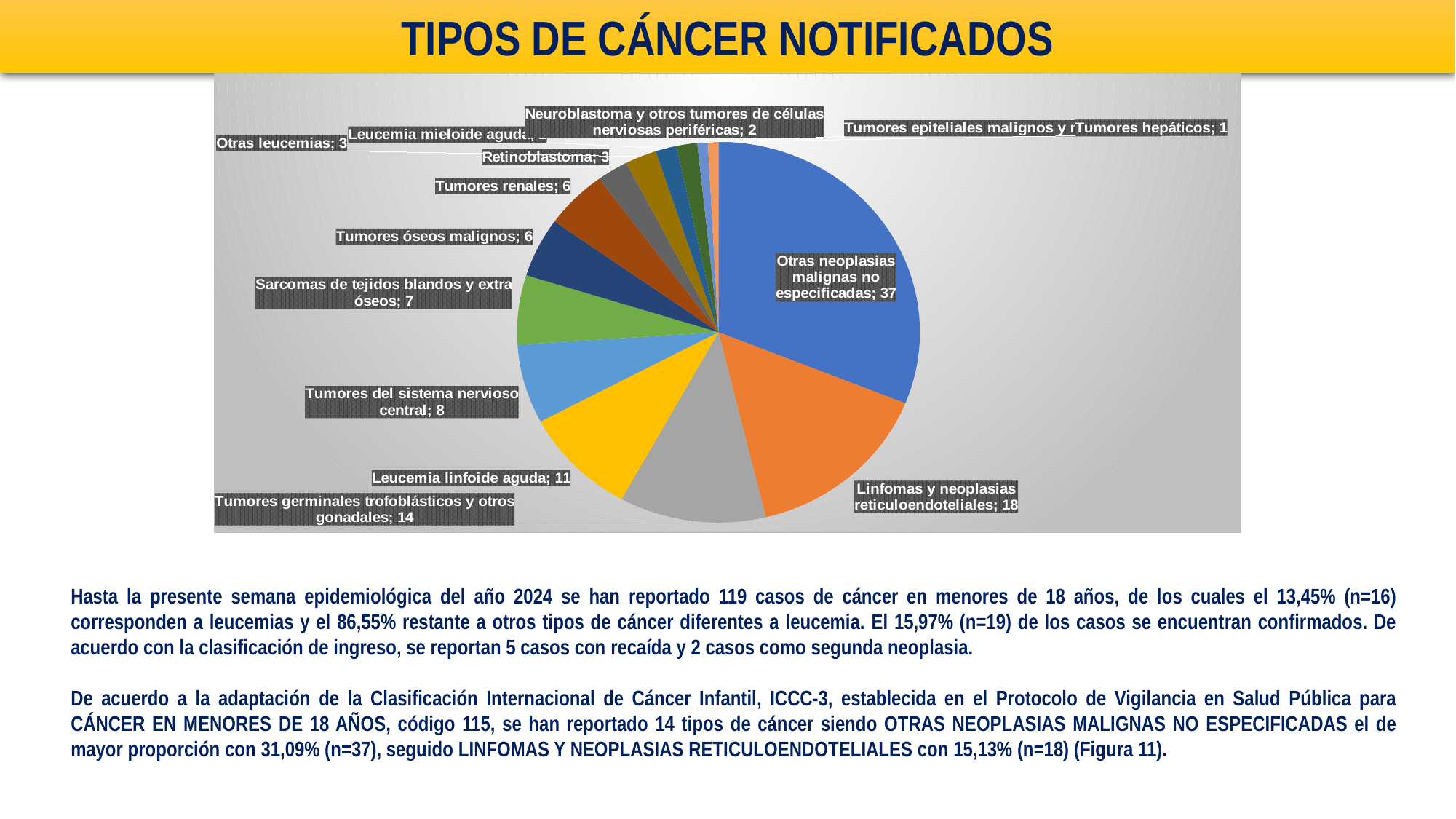
What is the difference between the values for 'Otras neoplasias malignas no especificadas' and 'Linfomas y neoplasias reticuloendoteliales'? 19 Which category has the largest slice of the pie? Otras neoplasias malignas no especificadas What is the value for 'Tumores del sistema nervioso central'? 8 Which is larger, the value for 'Leucemia linfoide aguda' or the value for 'Tumores del sistema nervioso central'? Leucemia linfoide aguda What type of chart is shown on the slide? pie chart What is the value for 'Tumores hepáticos'? 1 What is the value for 'Leucemia linfoide aguda'? 11 What is the difference between the values for 'Sarcomas de tejidos blandos y extra óseos' and 'Retinoblastoma'? 4 What is the title shown at the top of the slide? TIPOS DE CÁNCER NOTIFICADOS What is the value for 'Tumores germinales trofoblásticos y otros gonadales'? 14 What is the value for 'Linfomas y neoplasias reticuloendoteliales'? 18 What is the value for 'Otras neoplasias malignas no especificadas'? 37